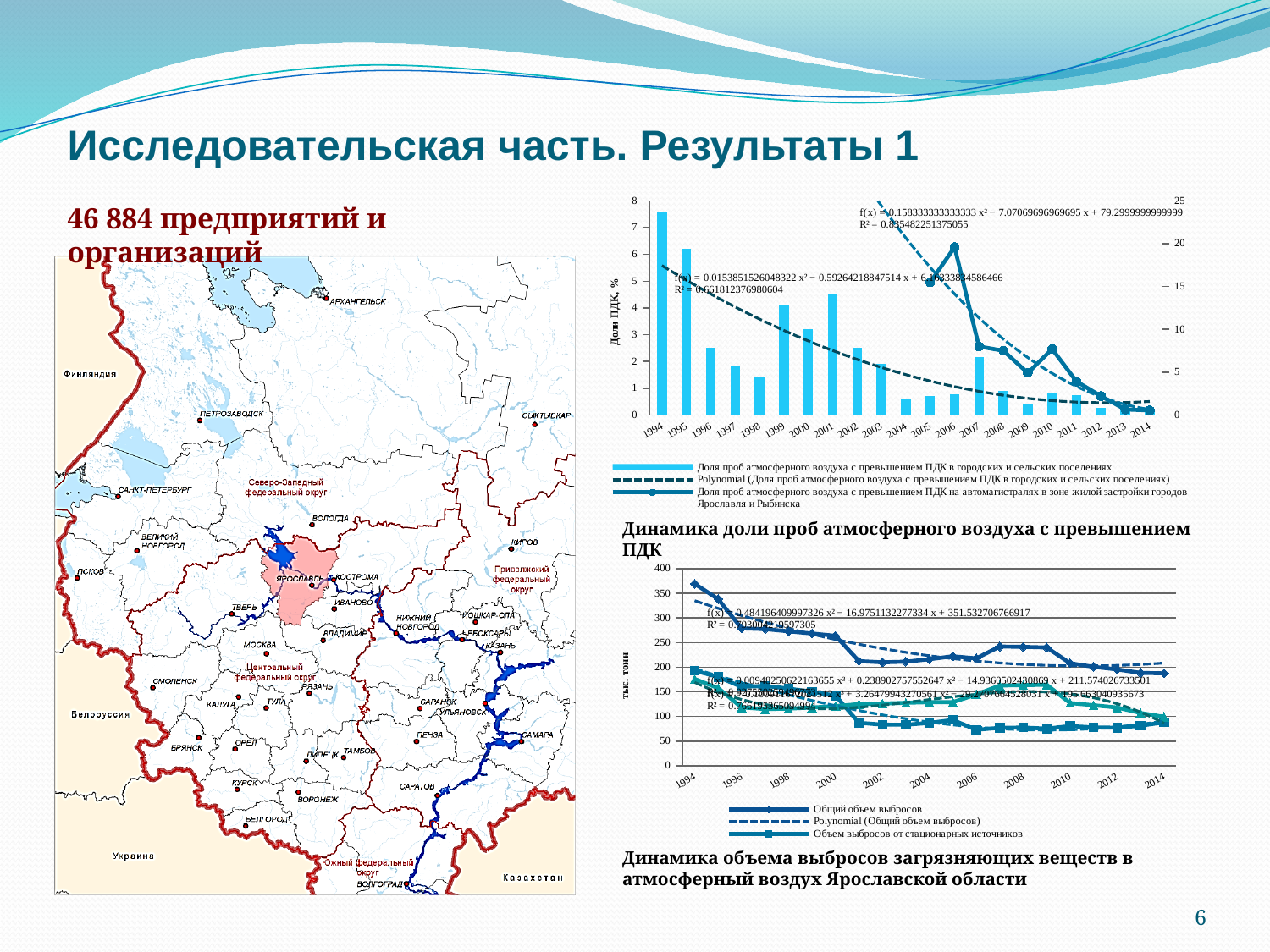
In the bottom chart 'Динамика объема выбросов загрязняющих веществ в атмосферный воздух Ярославской области', how many entries does the legend list? 3 In the bottom chart 'Динамика объема выбросов загрязняющих веществ в атмосферный воздух Ярославской области', is the value of 'Общий объем выбросов' for 1994 greater or less than 350? greater In the top chart 'Динамика доли проб атмосферного воздуха с превышением ПДК', what kind of chart is used for the series 'Доля проб атмосферного воздуха с превышением ПДК в городских и сельских поселениях'? bar chart In the top chart 'Динамика доли проб атмосферного воздуха с превышением ПДК', is the bar value for 1994 greater or less than 7? greater In the top chart 'Динамика доли проб атмосферного воздуха с превышением ПДК', what is the label of the left vertical axis? Доли ПДК, % In the top chart 'Динамика доли проб атмосферного воздуха с превышением ПДК', which year has the highest bar? 1994 In the bottom chart 'Динамика объема выбросов загрязняющих веществ в атмосферный воздух Ярославской области', what is the label of the vertical axis? тыс. тонн In the top chart 'Динамика доли проб атмосферного воздуха с превышением ПДК', is the bar value for 2001 greater or less than 4? greater In the bottom chart 'Динамика объема выбросов загрязняющих веществ в атмосферный воздух Ярославской области', in which year is 'Общий объем выбросов' highest? 1994 In the top chart 'Динамика доли проб атмосферного воздуха с превышением ПДК', do the bar values generally rise or fall from 1994 to 2014? fall In the top chart 'Динамика доли проб атмосферного воздуха с превышением ПДК', how many years are shown on the x axis? 21